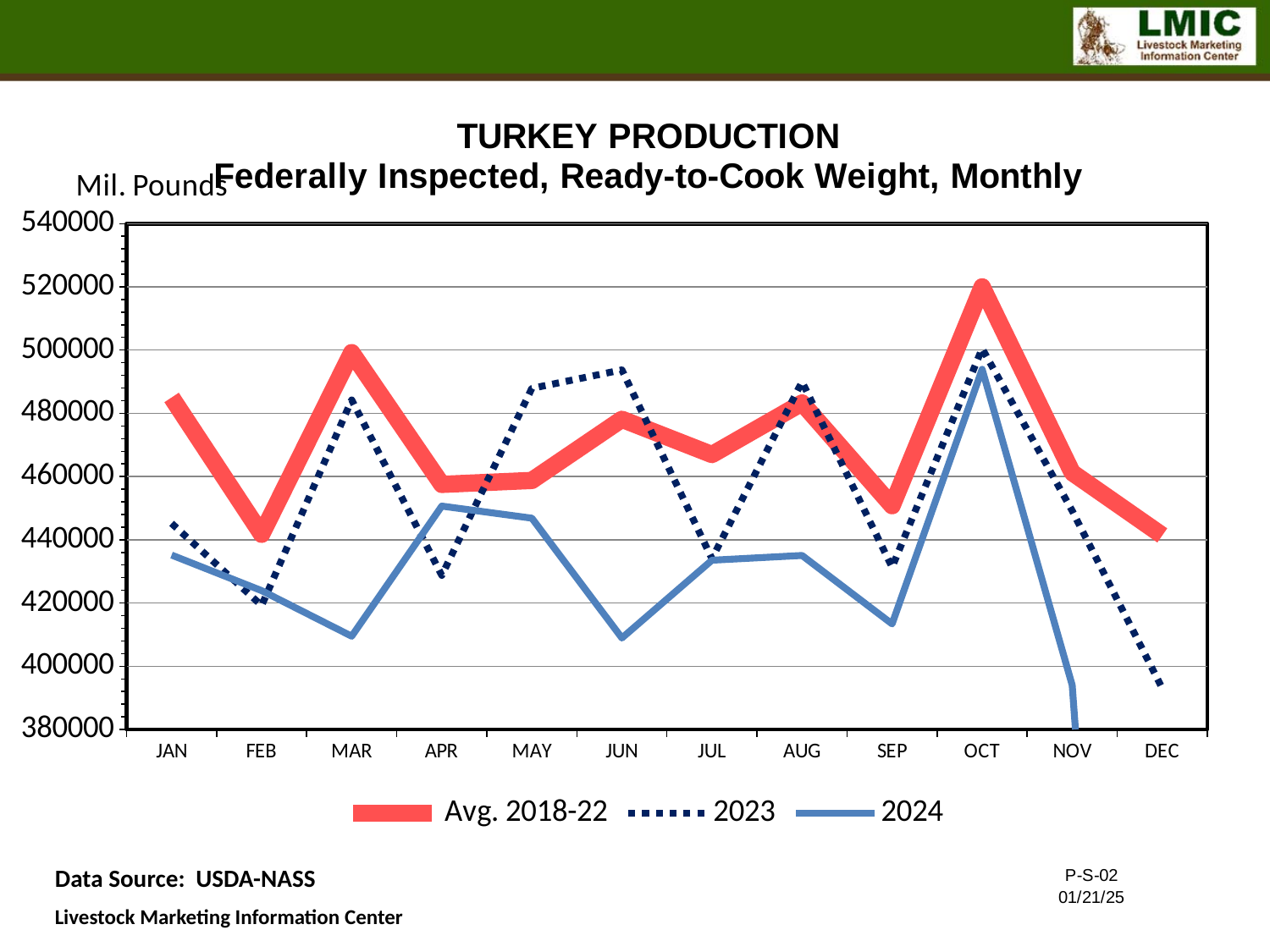
What unit is shown on the y axis label? Mil. Pounds In which month is the 2023 series at its lowest value? DEC Does the Avg. 2018-22 series rise or fall from OCT to DEC? Fall In which month does the 2024 series reach its highest value? OCT Is the 2024 value for MAR greater or less than 420000? less Is the 2023 value for JUN greater or less than 480000? greater In which month does the Avg. 2018-22 series reach its highest value? OCT In MAY, which series is higher: 2023 or Avg. 2018-22? 2023 What kind of chart is shown on the slide? Line chart Is the Avg. 2018-22 value for OCT greater or less than 500000? greater How many months are plotted along the x axis? 12 How many series does the legend list? 3